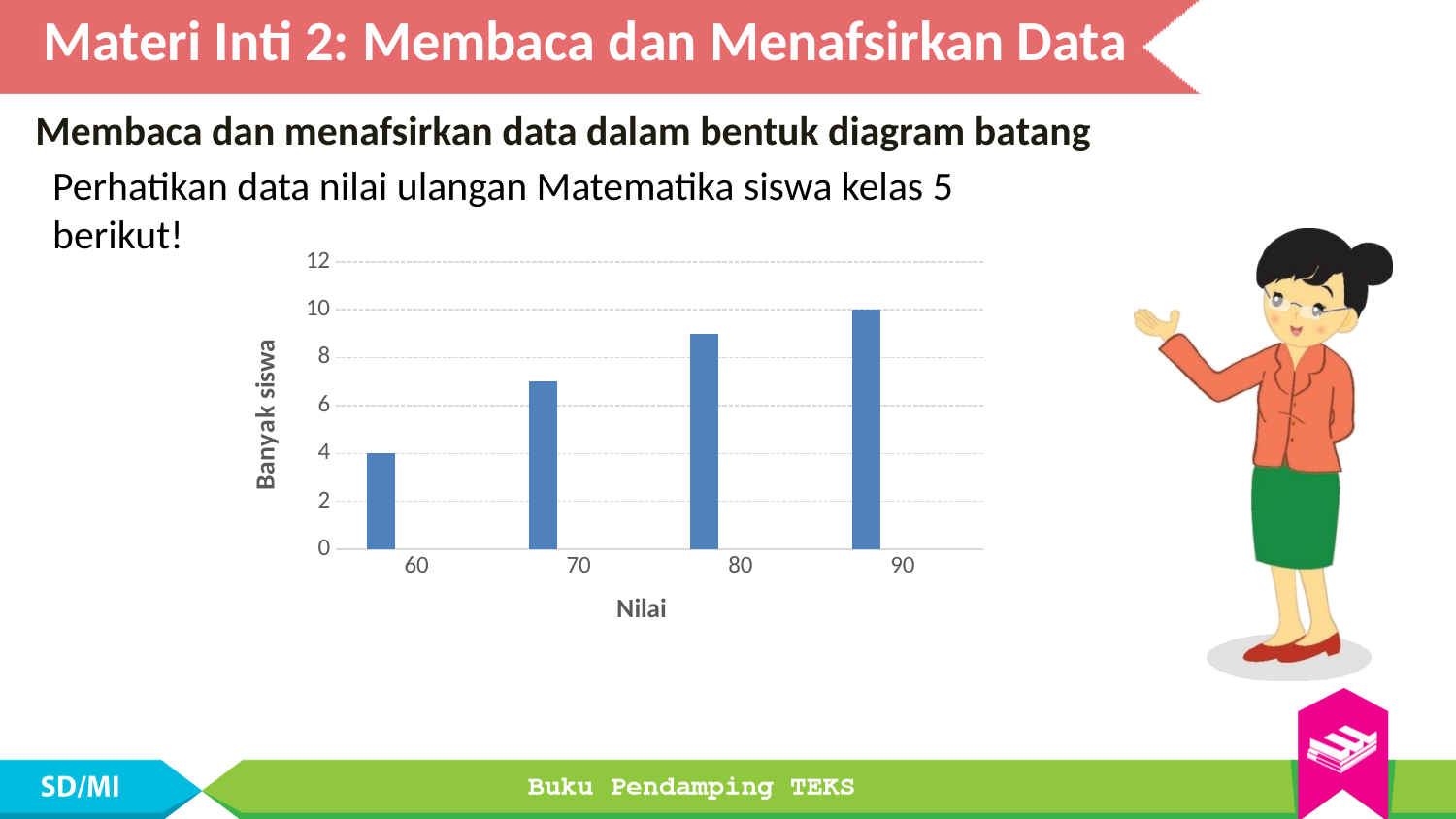
Is the value for Nilai 70 greater or less than 8? less Is the value for Nilai 70 greater or less than 6? greater Which Nilai category has the lowest number of students? 60 What is the difference between the number of students scoring 90 and the number scoring 60? 6 How many students (Banyak siswa) scored 60 (Nilai 60)? 4 What kind of chart is shown on the slide? bar chart How many Nilai categories are shown on the x axis? 4 Is the value for Nilai 80 greater or less than 8? greater Which Nilai category has the highest number of students? 90 Do the values rise or fall as Nilai increases from 60 to 90? rise How many students scored 90 according to the chart? 10 Which has more students, Nilai 70 or Nilai 80? 80